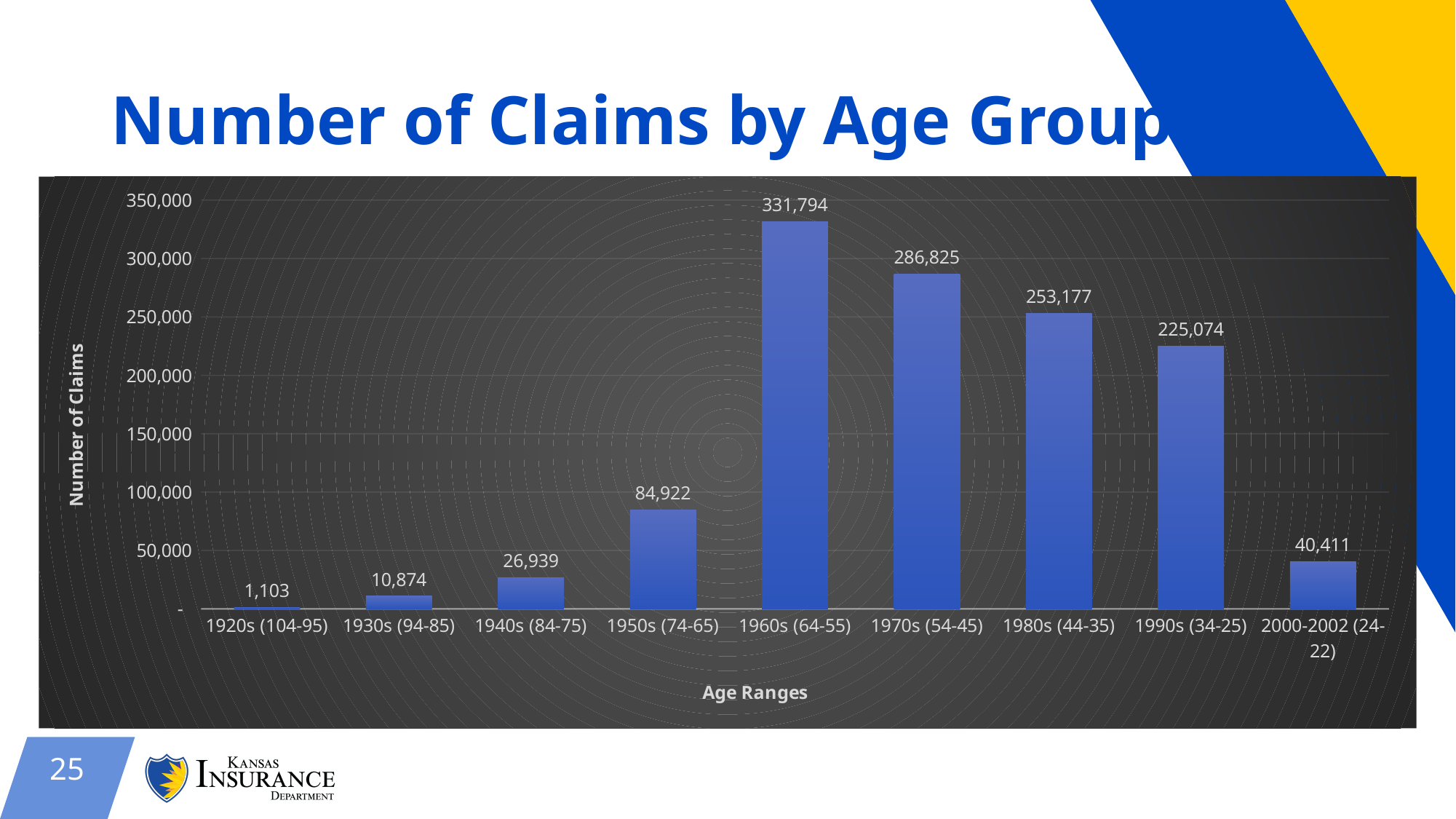
Do the number of claims rise or fall from the 1960s (64-55) group to the 2000-2002 (24-22) group? Fall What is the number of claims for the 1960s (64-55) age group? 331,794 What is the number of claims for the 2000-2002 (24-22) age group? 40,411 Which age group has more claims, 1980s (44-35) or 1990s (34-25)? 1980s (44-35) What is the label of the y axis? Number of Claims What is the difference in number of claims between the 1960s (64-55) and 1970s (54-45) age groups? 44,969 Which age group has the highest number of claims? 1960s (64-55) What type of chart is shown on the slide? Bar chart How many age groups are shown on the x axis? 9 Which age group has the lowest number of claims? 1920s (104-95) What is the difference in number of claims between the 1950s (74-65) and 1940s (84-75) age groups? 57,983 What is the number of claims for the 1920s (104-95) age group? 1,103